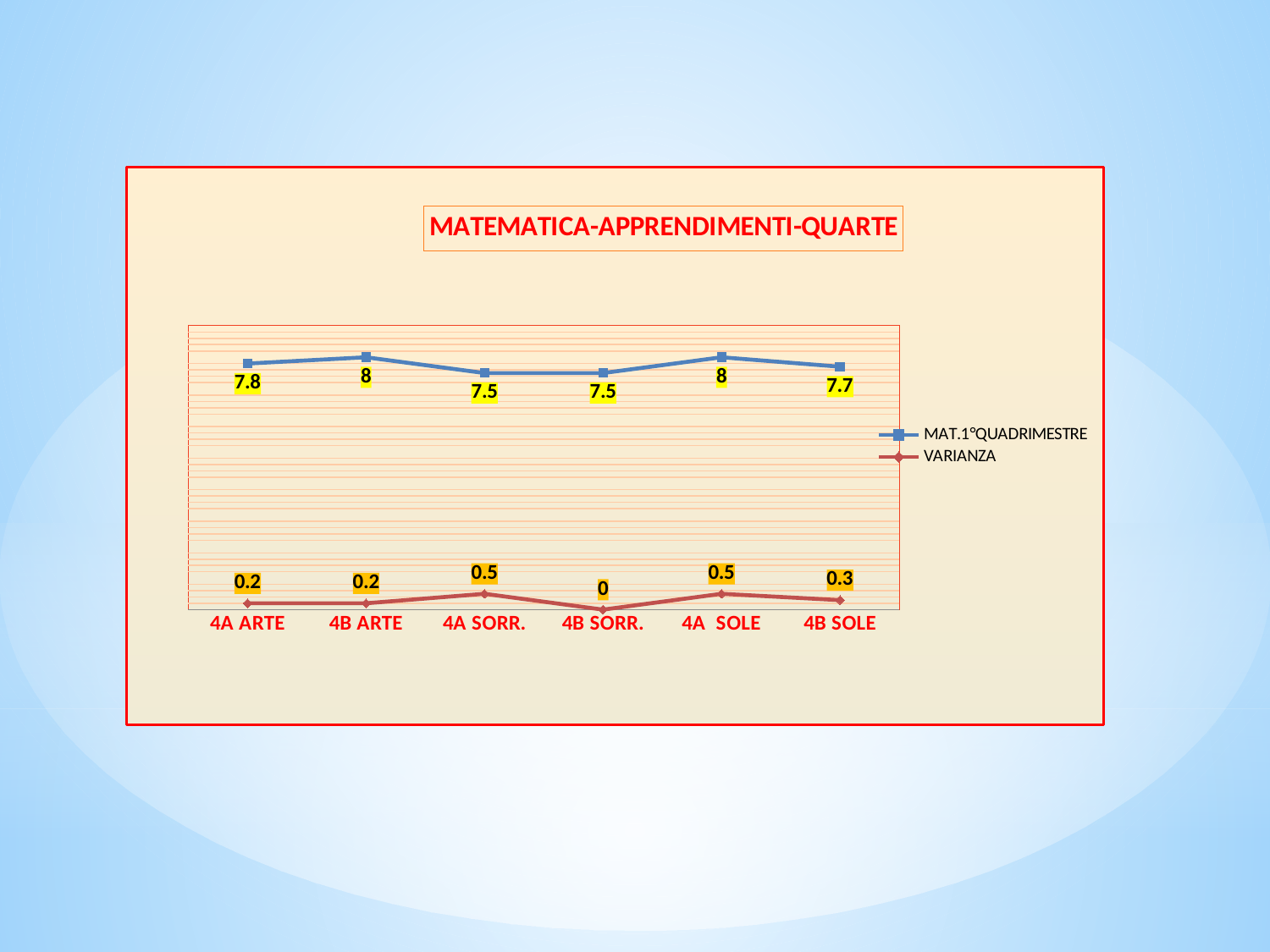
How many series does the legend list? 2 What is the difference between the MAT.1°QUADRIMESTRE values for 4B ARTE and 4A SORR.? 0.5 What is the MAT.1°QUADRIMESTRE value for 4A ARTE? 7.8 Which is larger, the MAT.1°QUADRIMESTRE value for 4A ARTE or for 4B SOLE? 4A ARTE How many categories are shown on the x axis? 6 Which category has the lowest VARIANZA value? 4B SORR. What kind of chart is shown on the slide? Line chart Which categories share the highest MAT.1°QUADRIMESTRE value of 8? 4B ARTE and 4A SOLE What is the title of the chart? MATEMATICA-APPRENDIMENTI-QUARTE What is the MAT.1°QUADRIMESTRE value for 4B SOLE? 7.7 What is the VARIANZA value for 4A SORR.? 0.5 What is the difference between the VARIANZA values for 4A SOLE and 4B SOLE? 0.2